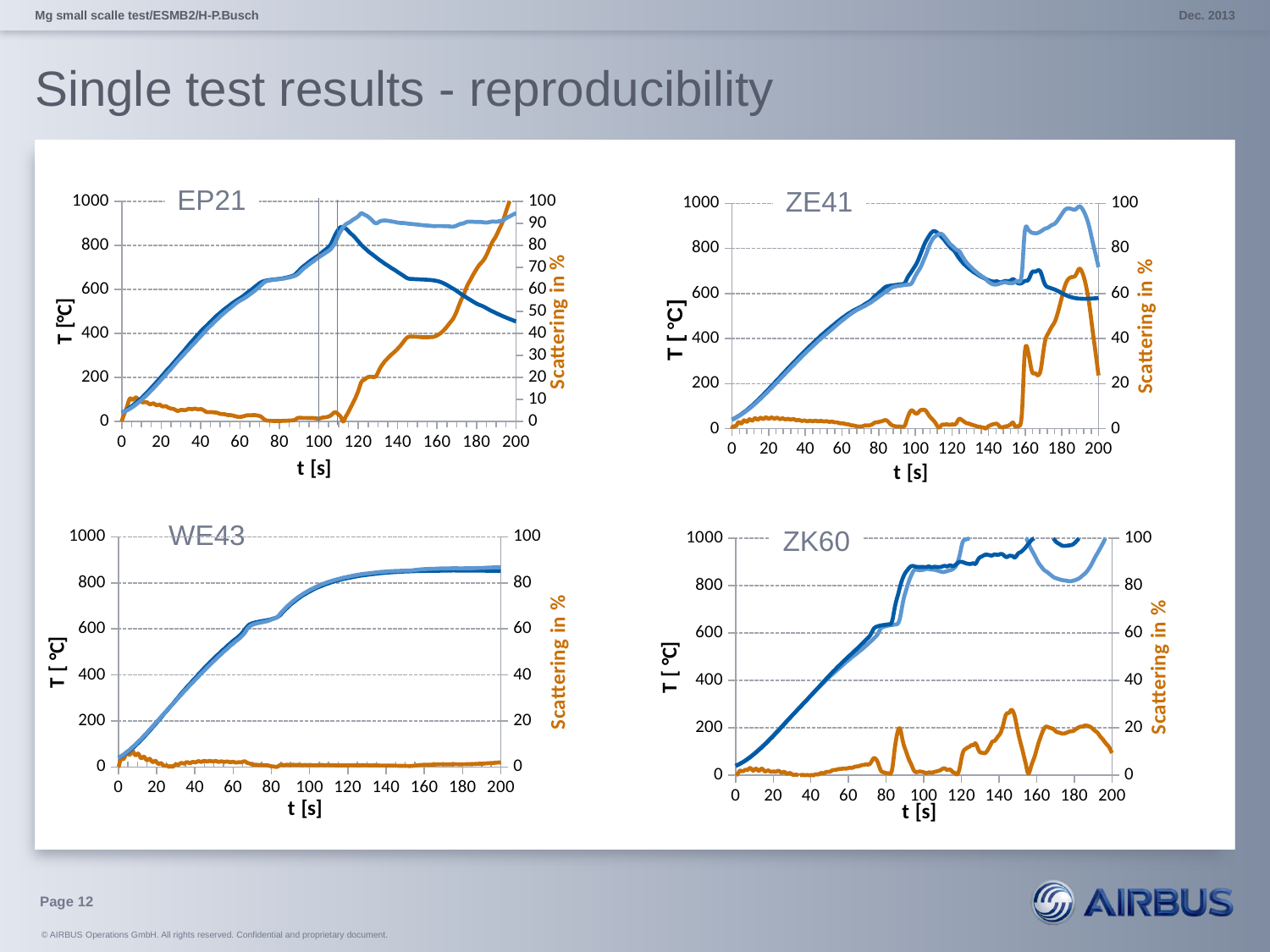
What kind of chart is the EP21 chart? line chart In the EP21 chart, does the dark blue temperature line rise or fall between t = 120 and t = 200 s? fall In the ZK60 chart, is the scattering value at t = 100 s greater or less than 20? less What is the right-hand axis title of the ZE41 chart? Scattering in % How many charts are shown on the slide? 4 In the WE43 chart, is the scattering value at t = 100 s greater or less than 20? less In the WE43 chart, is the temperature at t = 200 s greater or less than 800? greater What is the x-axis title of the WE43 chart? t [s] In the WE43 chart, does the temperature rise or fall between t = 0 and t = 100 s? rise